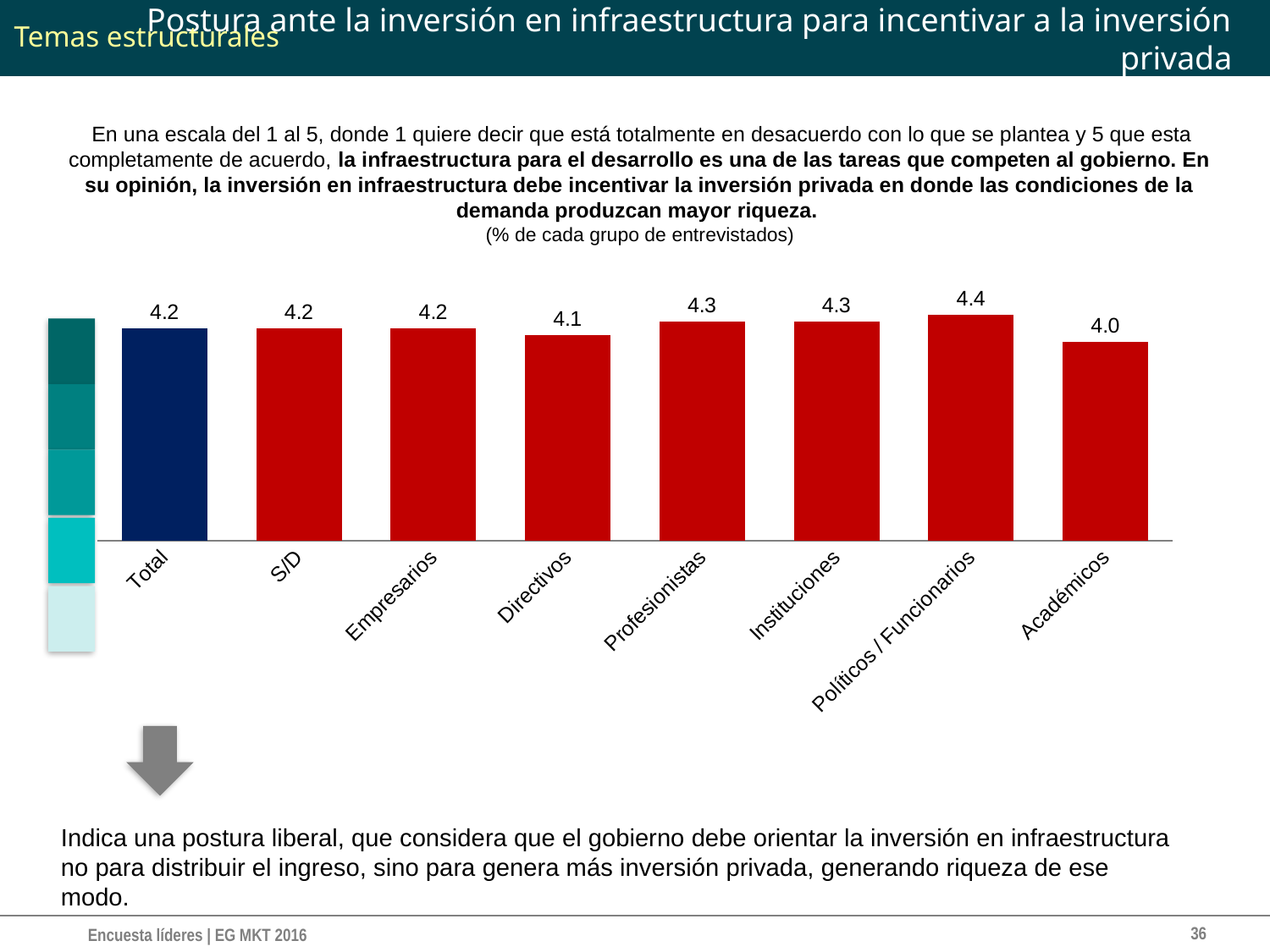
Which is larger, the value for Instituciones or the value for Directivos? Instituciones Which category has the lowest value? Académicos What colour is the bar for Total? Dark blue Which category has the highest value? Políticos / Funcionarios What is the value for Total? 4.2 How many categories are shown on the x axis? 8 What is the difference between the values for Políticos / Funcionarios and Académicos? 0.4 What kind of chart is shown on the slide? Bar chart What is the value for Profesionistas? 4.3 What is the value for Directivos? 4.1 What is the value for Políticos / Funcionarios? 4.4 What is the value for Académicos? 4.0